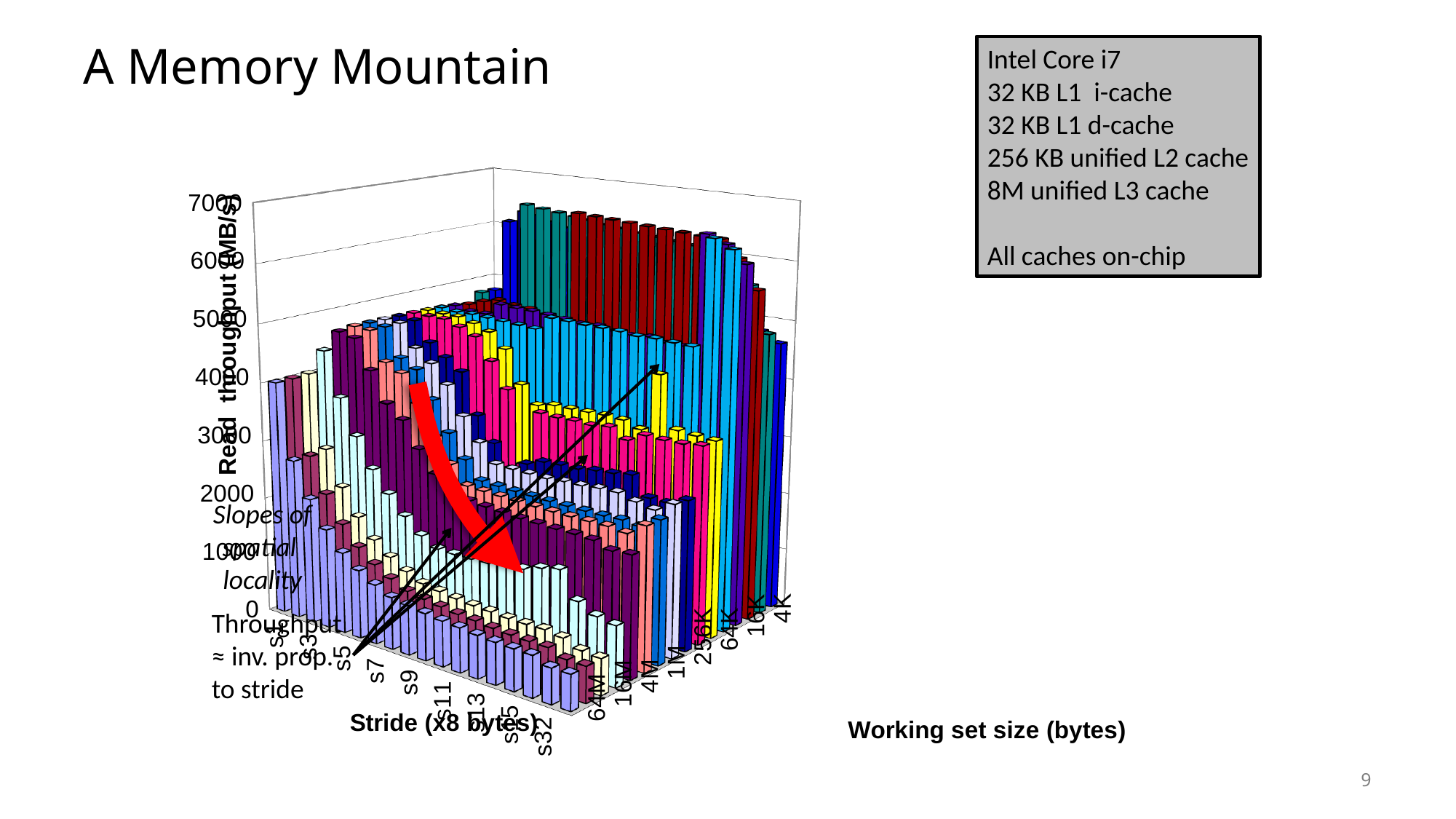
Which is larger: the read throughput at stride s1 for working set 4K, or at stride s1 for working set 64M? 4K What is the title of the chart on the slide? A Memory Mountain Which working set size label is at the far end of the depth axis, next to 16K? 4K What is the highest tick value shown on the vertical axis? 7000 Is the read throughput for the bar at stride s32 and working set 64M greater or less than 3000? less What quantity is plotted on the vertical axis of the chart? Read throughput (MB/s) Does read throughput rise or fall as the working set size decreases from 64M toward 4K? rise How many working set size labels are shown along the depth axis of the chart? 8 For a large working set such as 64M, does read throughput rise or fall as the stride increases from s1 to s32? fall What kind of chart is shown on the slide? bar chart